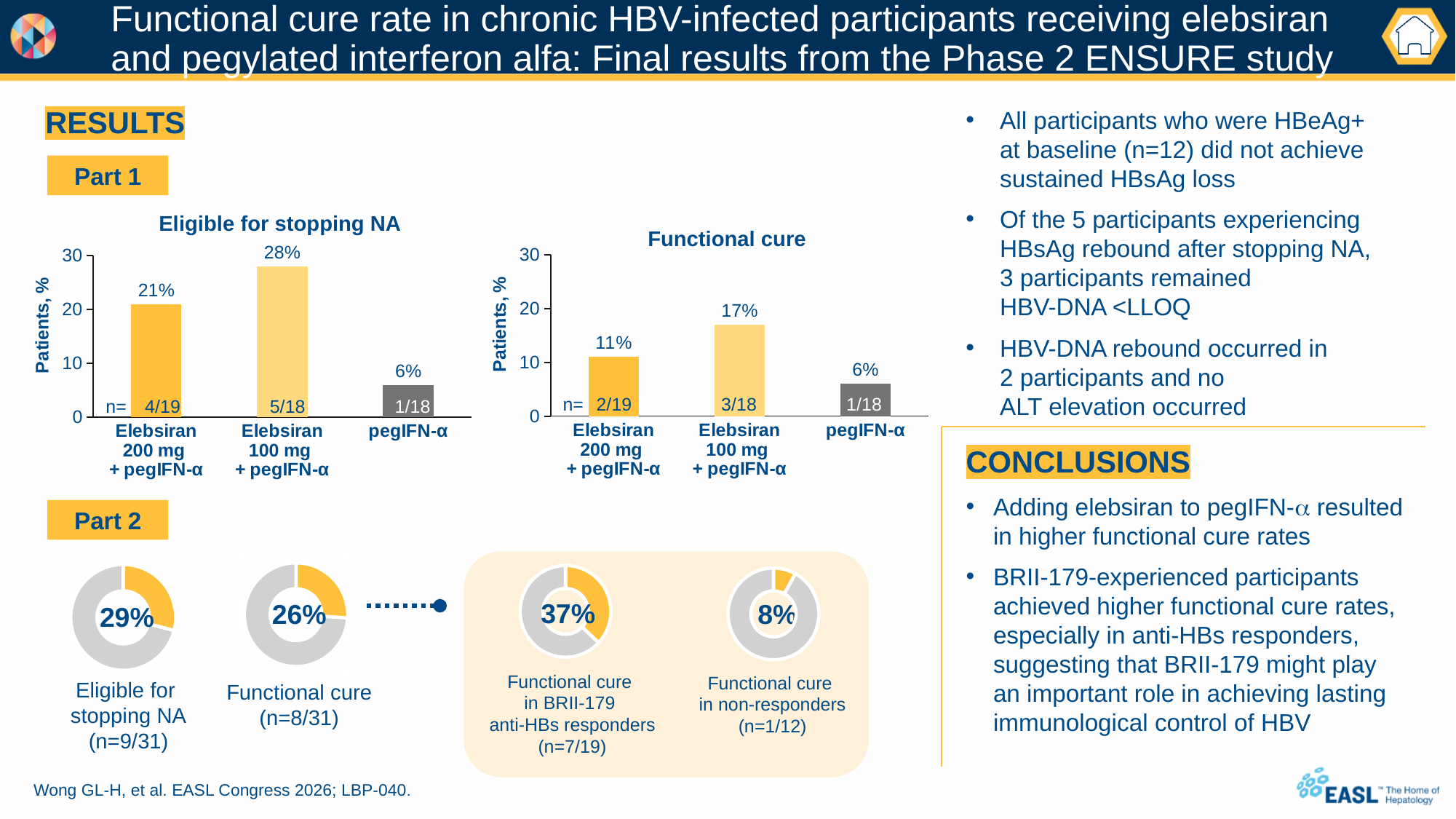
In the 'Functional cure' bar chart, what is the value for Elebsiran 200 mg + pegIFN-α? 11% In the 'Eligible for stopping NA' chart, what is the value for Elebsiran 100 mg + pegIFN-α? 28% In the 'Eligible for stopping NA' chart, which group has the lowest value? pegIFN-α In Part 2, what percentage is shown in the donut chart for functional cure in BRII-179 anti-HBs responders? 37% In the 'Eligible for stopping NA' chart, what is the n= label shown on the Elebsiran 100 mg + pegIFN-α bar? 5/18 How many groups are shown in the 'Functional cure' bar chart? 3 What type of chart is the 'Eligible for stopping NA' chart? Bar chart In the 'Functional cure' bar chart, what is the difference between Elebsiran 100 mg + pegIFN-α and Elebsiran 200 mg + pegIFN-α? 6% In the 'Functional cure' bar chart, which is larger: Elebsiran 200 mg + pegIFN-α or pegIFN-α? Elebsiran 200 mg + pegIFN-α In the 'Eligible for stopping NA' chart, what is the difference between Elebsiran 100 mg + pegIFN-α and pegIFN-α? 22% In the 'Functional cure' bar chart, which group has the highest value? Elebsiran 100 mg + pegIFN-α In the 'Eligible for stopping NA' chart, is the value for Elebsiran 200 mg + pegIFN-α greater or less than 20? greater